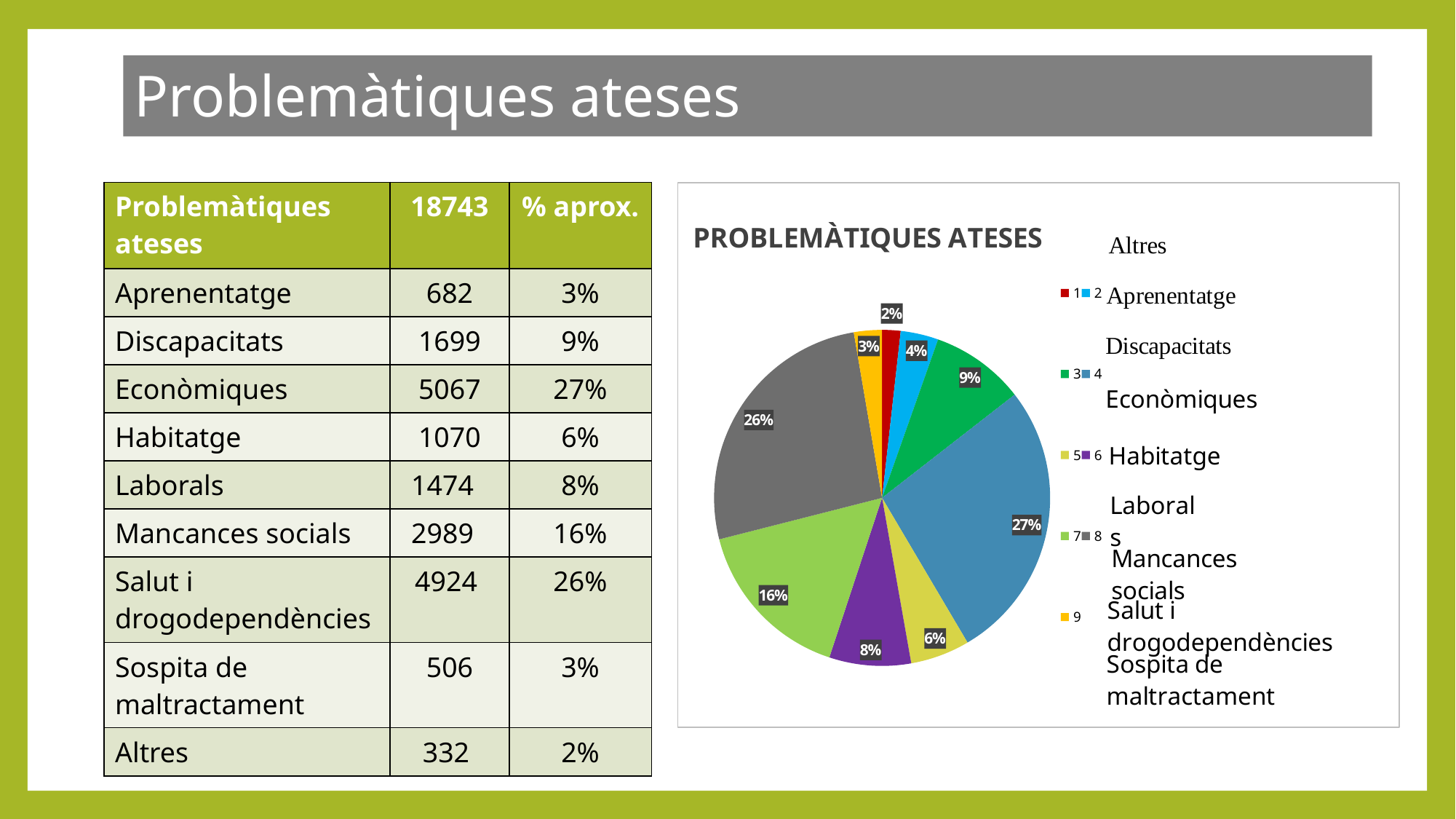
What share of the pie does Mancances socials represent? 16% What share of the pie does Salut i drogodependències represent? 26% Which is larger in the pie chart, the slice for Salut i drogodependències or the slice for Mancances socials? Salut i drogodependències What is the largest percentage shown on any slice of the pie chart? 27% What is the difference in percentage points between the Econòmiques slice and the Salut i drogodependències slice? 1% Which category has the largest slice of the pie chart? Econòmiques What kind of chart is shown on the slide? pie chart What is the title of the chart? PROBLEMÀTIQUES ATESES What is the smallest percentage shown on any slice of the pie chart? 2% What share of the pie does Econòmiques represent? 27% How many slices does the pie chart have? 9